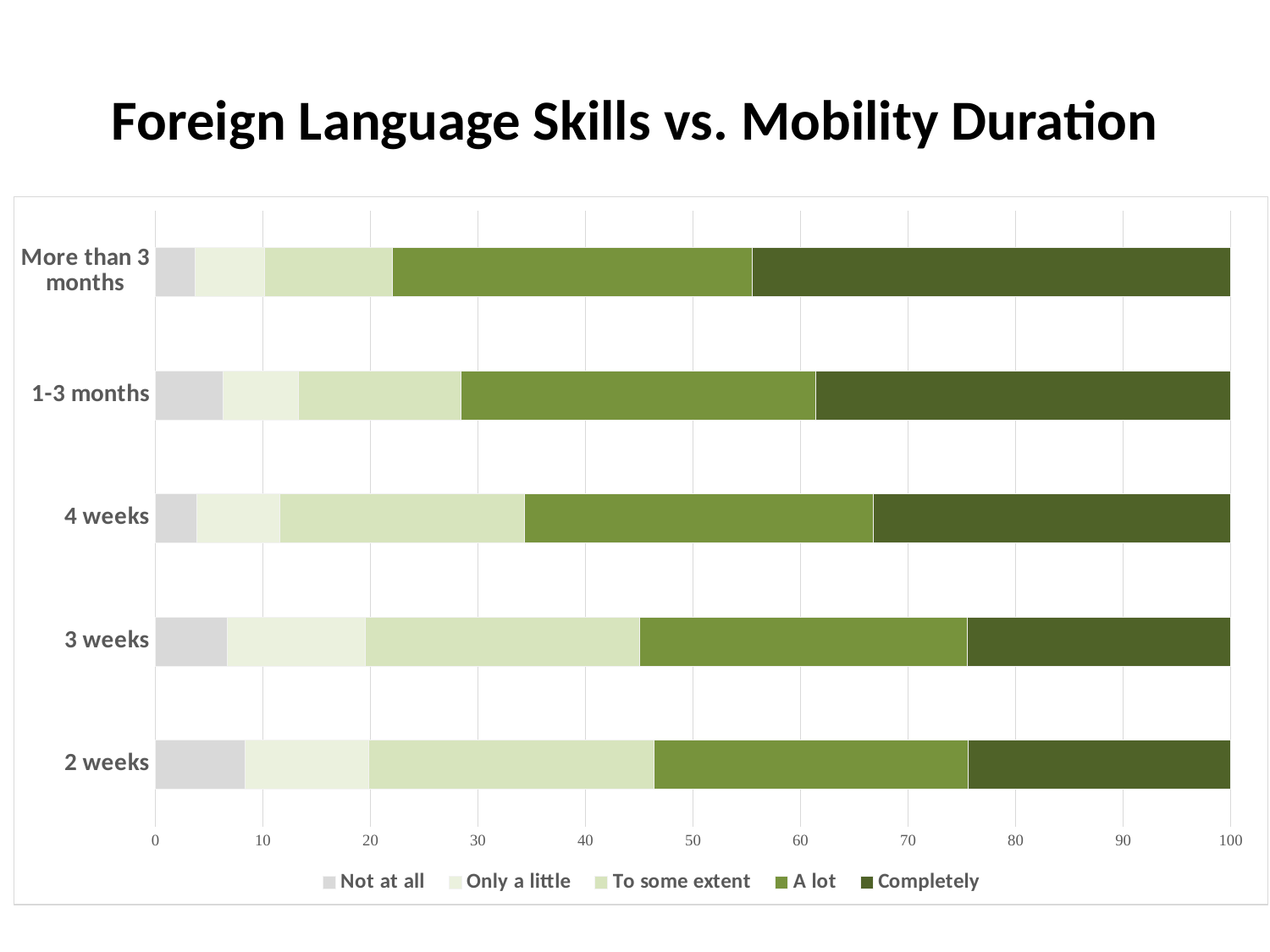
Which mobility duration has the largest 'Not at all' segment? 2 weeks Is the 'Completely' segment for More than 3 months greater or less than 40? greater What is the title of the chart? Foreign Language Skills vs. Mobility Duration Is the 'Completely' segment for 2 weeks greater or less than 30? less Which mobility duration has the largest 'Completely' segment? More than 3 months Which series is listed last in the legend? Completely How many mobility duration categories are shown on the chart? 5 What is the total of the stacked bar for 2 weeks? 100 How many series does the legend list? 5 Which has a larger 'Completely' segment, 1-3 months or 4 weeks? 1-3 months Which mobility duration has the smallest 'To some extent' segment? More than 3 months What kind of chart is shown on the slide? bar chart